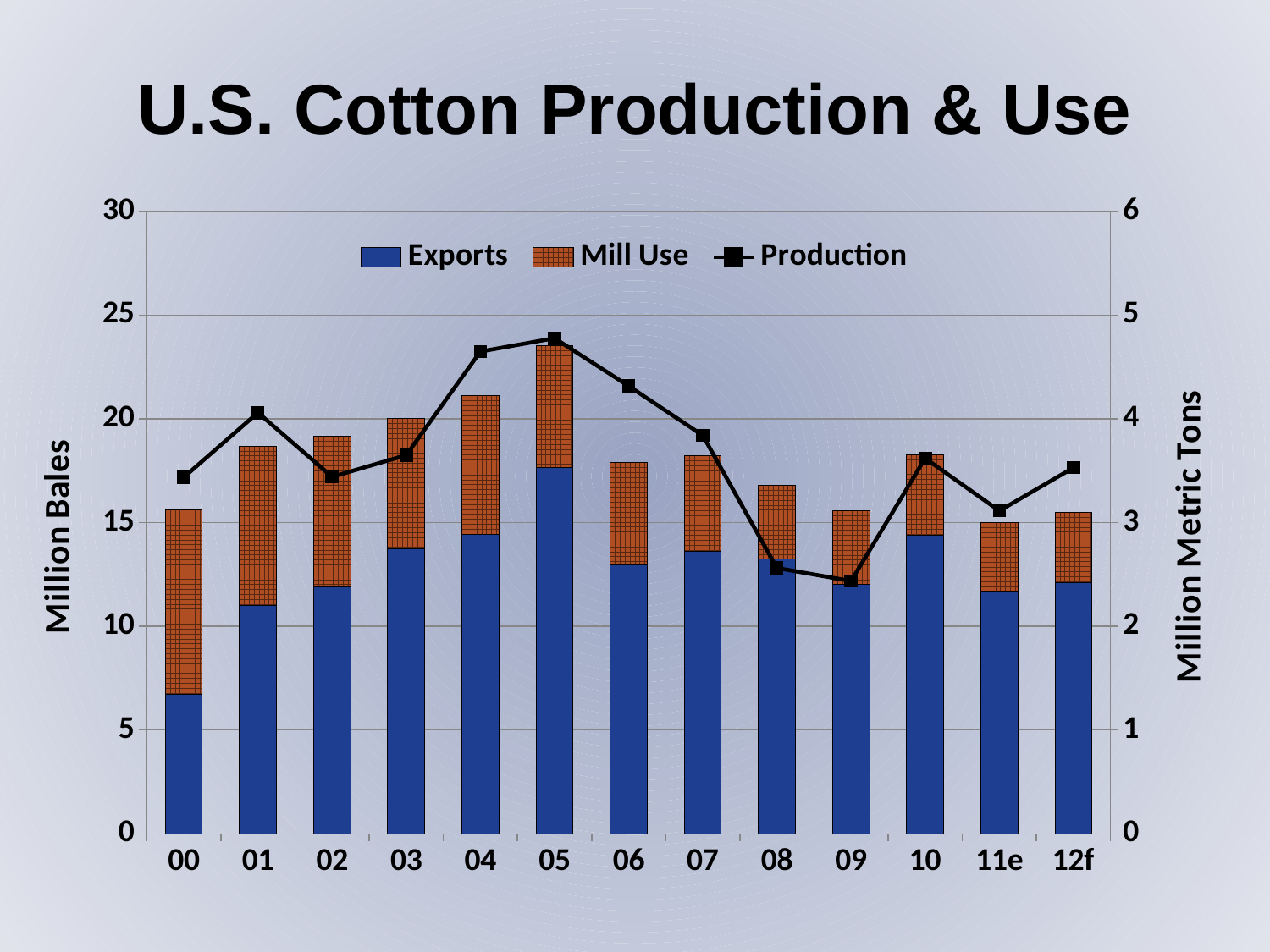
How many years are shown along the x axis? 13 Which year has larger Exports, 01 or 04? 04 How many series does the legend list? 3 Which year has the tallest stacked bar (Exports plus Mill Use)? 05 Is the value for Exports in 05 greater or less than 15? greater What is the title of the left vertical axis? Million Bales In which year is Production highest? 05 Is the value for Exports in 00 greater or less than 10? less In which year is Production lowest? 09 Is the value for Production in 08 greater or less than 3? less Does Production rise or fall from 05 to 09? fall What kind of chart is shown on the slide? bar chart with a line